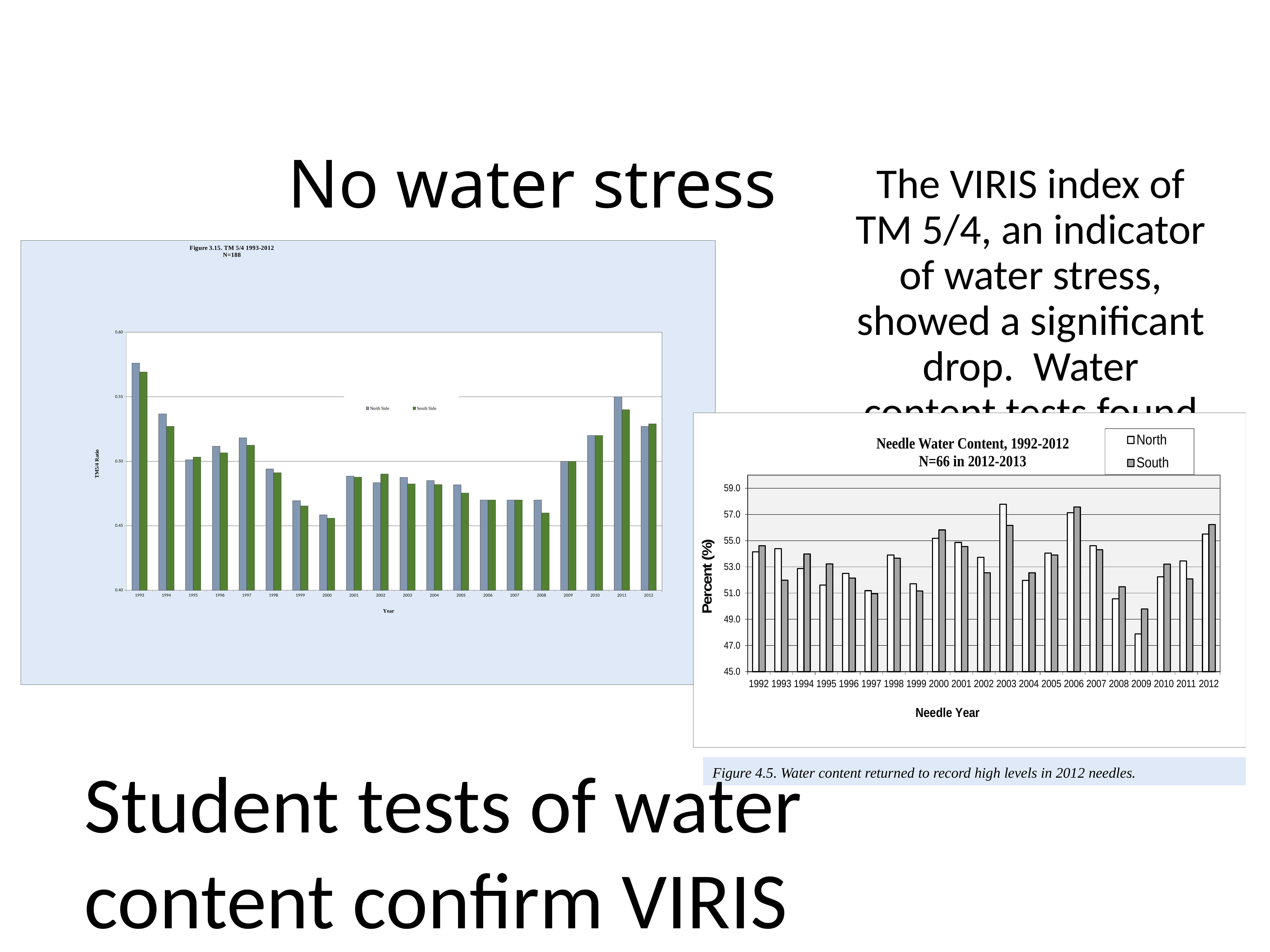
In the 'Figure 3.15. TM 5/4 1993-2012' chart, which year has the highest North Side bar? 1993 How many years are shown on the x axis of the 'Needle Water Content, 1992-2012' chart? 21 In the 'Figure 3.15. TM 5/4 1993-2012' chart, is the South Side value for 2000 greater or less than 0.50? less In the 'Needle Water Content, 1992-2012' chart, is the South value for 2012 greater or less than 55.0? greater How many years are shown on the x axis of the 'Figure 3.15. TM 5/4 1993-2012' chart? 20 In the 'Needle Water Content, 1992-2012' chart, which is larger for 2003, the North value or the South value? North In the 'Needle Water Content, 1992-2012' chart, which year has the lowest North bar? 2009 How many series does the legend of the 'Needle Water Content, 1992-2012' chart list? 2 What kind of chart is the 'Figure 3.15. TM 5/4 1993-2012' chart on the left? bar chart What are the two series named in the legend of the 'Figure 3.15. TM 5/4 1993-2012' chart? North Side and South Side In the 'Figure 3.15. TM 5/4 1993-2012' chart, is the North Side value for 1993 greater or less than 0.55? greater